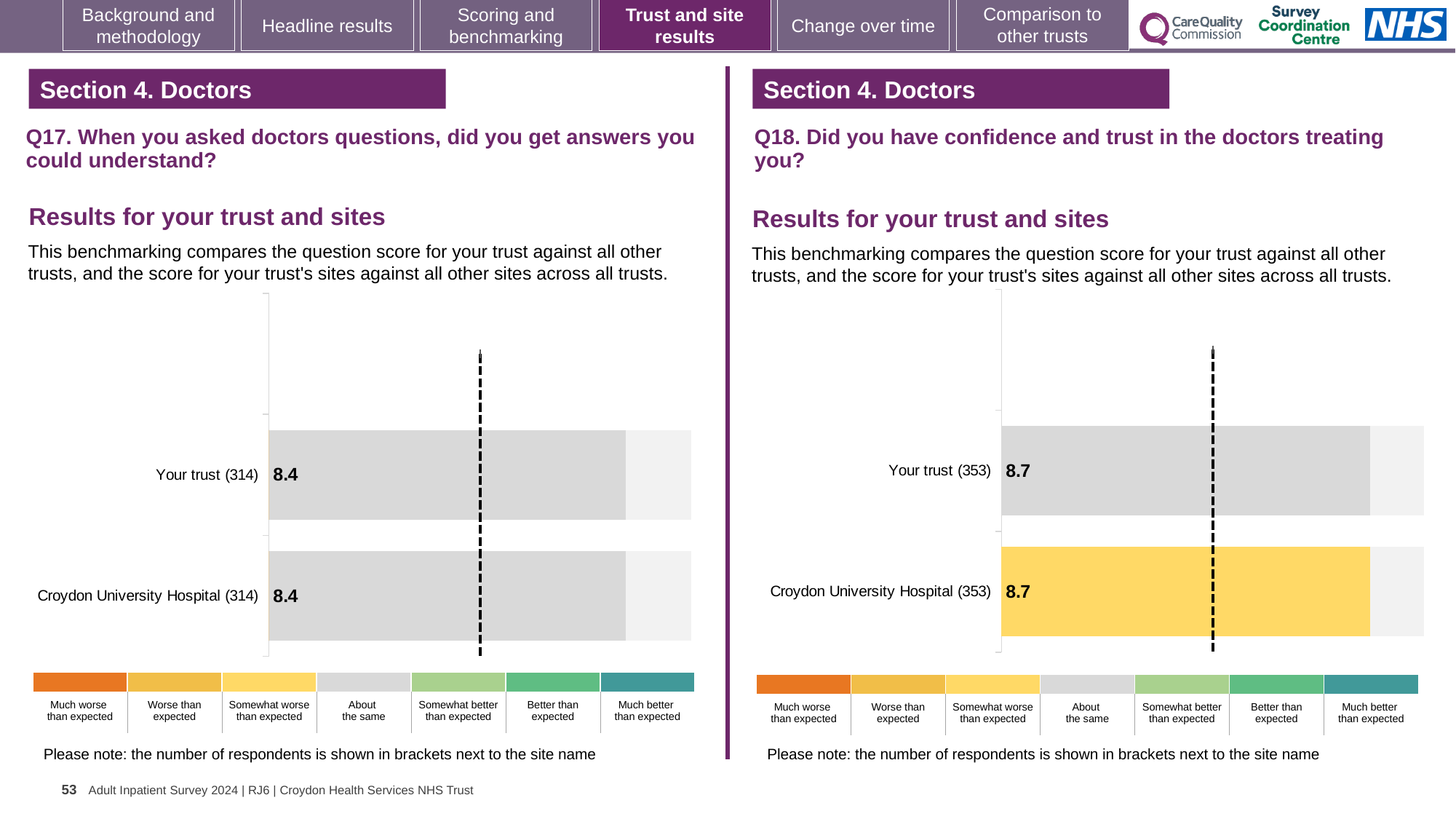
On the Q17 chart (left), how many respondents are shown in brackets next to Your trust? 314 On the Q18 chart (right), what is the score for Croydon University Hospital? 8.7 On the Q18 chart (right), how many respondents are shown in brackets next to Croydon University Hospital? 353 On the Q18 chart (right), what colour is the bar for Croydon University Hospital? Yellow On the Q18 chart (right), what is the score for Your trust? 8.7 On the Q17 chart (left), what is the score for Your trust? 8.4 On the Q18 chart (right), what is the difference between the score for Your trust and the score for Croydon University Hospital? 0 On the Q18 chart (right), which benchmark category does the yellow colour of the Croydon University Hospital bar correspond to in the key? Somewhat worse than expected On the Q18 chart (right), how many bars are plotted? 2 On the Q17 chart (left), what is the score for Croydon University Hospital? 8.4 What kind of chart is the Q17 chart on the left? Bar chart On the Q17 chart (left), how many bars are plotted? 2